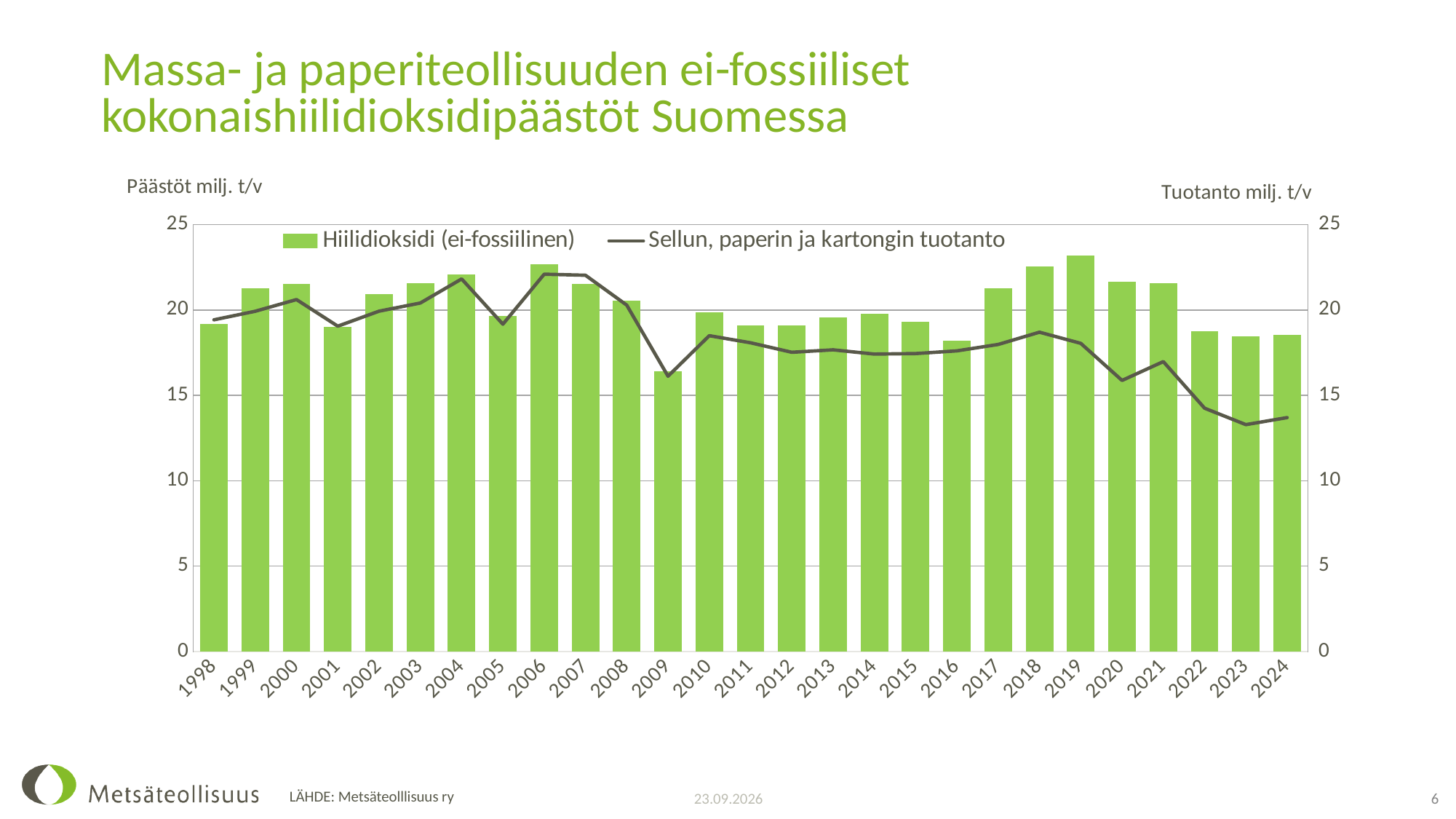
Is the Sellun, paperin ja kartongin tuotanto value for 2000 greater or less than 20? greater In which year is the Hiilidioksidi (ei-fossiilinen) bar the highest? 2019 How many series does the legend list? 2 Does the Sellun, paperin ja kartongin tuotanto line rise or fall from 2019 to 2023? Fall How many years are shown on the x axis? 27 Is the Hiilidioksidi (ei-fossiilinen) value for 2019 greater or less than 20? greater Is the Hiilidioksidi (ei-fossiilinen) value for 2009 greater or less than 20? less In which year is the Hiilidioksidi (ei-fossiilinen) bar the lowest? 2009 What is the label of the left vertical axis? Päästöt milj. t/v Which year has the larger Hiilidioksidi (ei-fossiilinen) bar, 2006 or 2016? 2006 What kind of chart is shown on the slide? A combined bar and line chart